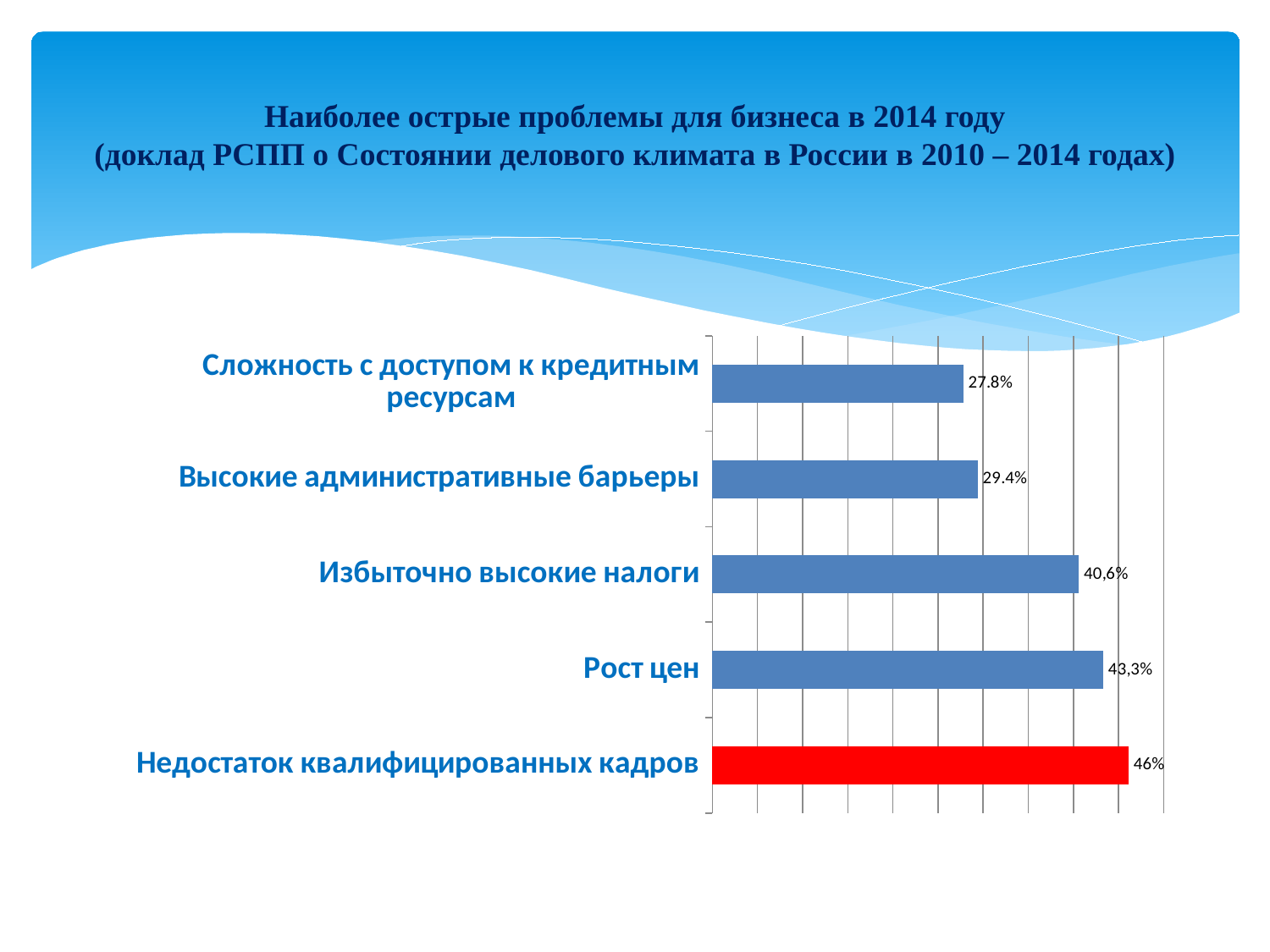
What is the value for «Избыточно высокие налоги»? 40,6% How many categories are shown in the chart? 5 What is the value for «Высокие административные барьеры»? 29.4% Which category's bar is coloured red? Недостаток квалифицированных кадров What kind of chart is shown on the slide? Bar chart What is the value for «Недостаток квалифицированных кадров»? 46% Which category has the lowest value? Сложность с доступом к кредитным ресурсам What is the value for «Сложность с доступом к кредитным ресурсам»? 27.8% What is the value for «Рост цен»? 43,3% Which category has the highest value? Недостаток квалифицированных кадров Which is larger: the value for «Избыточно высокие налоги» or for «Высокие административные барьеры»? Избыточно высокие налоги What is the difference between the values for «Рост цен» and «Избыточно высокие налоги»? 2,7%